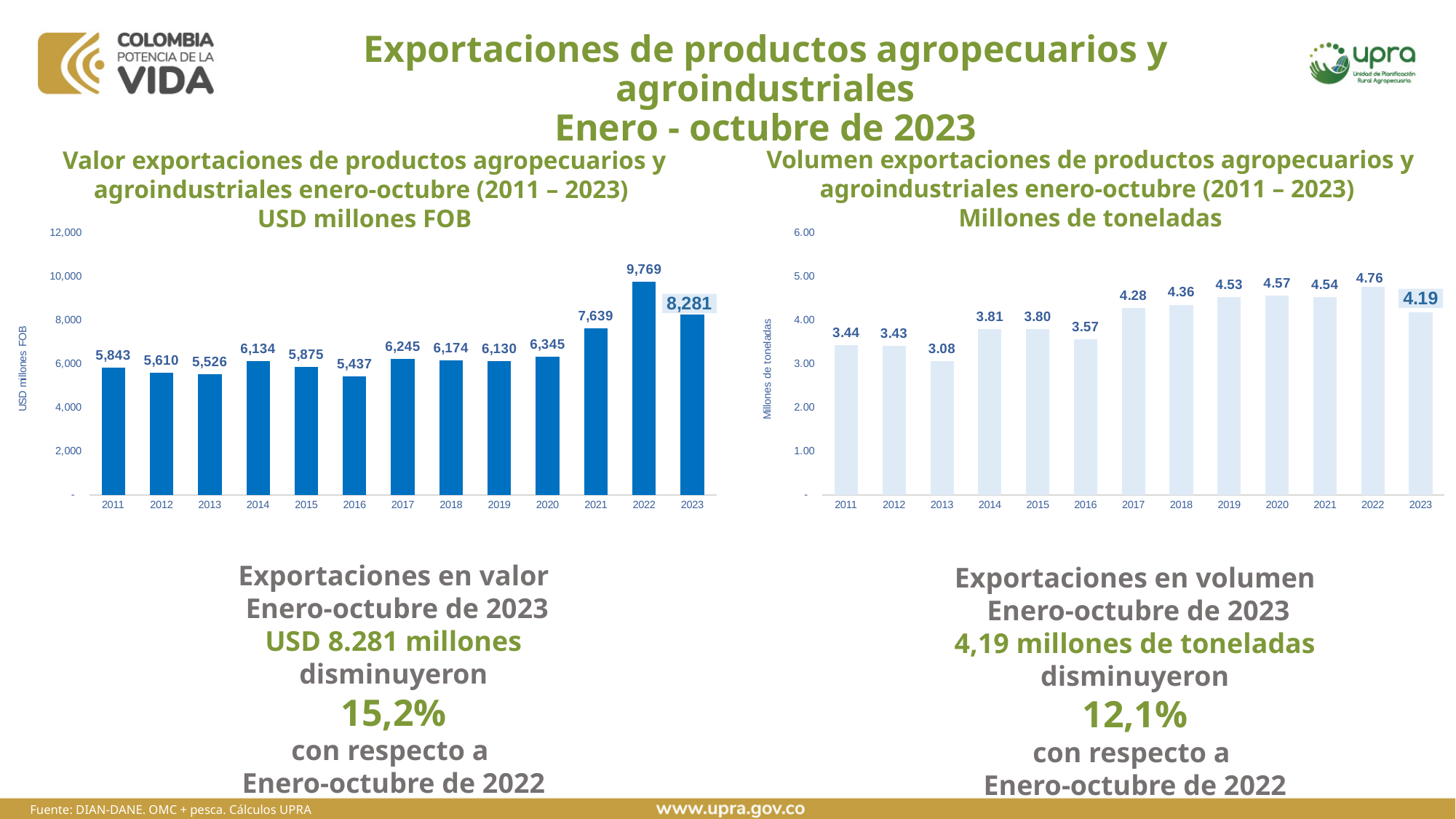
What is the y-axis label of the right chart (Volumen exportaciones)? Millones de toneladas What kind of chart is the left chart (Valor exportaciones, USD millones FOB)? Bar chart In the left chart (Valor exportaciones, USD millones FOB), what is the value for 2023? 8,281 In the right chart (Volumen exportaciones, Millones de toneladas), which year has the lowest value? 2013 In the left chart (Valor exportaciones, USD millones FOB), how many years are plotted? 13 In the right chart (Volumen exportaciones, Millones de toneladas), which is larger: the value for 2017 or the value for 2023? 2017 In the left chart (Valor exportaciones, USD millones FOB), which year has the highest value? 2022 In the left chart (Valor exportaciones, USD millones FOB), what is the difference between the 2022 and 2023 values? 1,488 In the right chart (Volumen exportaciones, Millones de toneladas), what is the difference between the 2022 and 2023 values? 0.57 In the right chart (Volumen exportaciones, Millones de toneladas), what is the value for 2019? 4.53 In the right chart (Volumen exportaciones, Millones de toneladas), which year has the highest value? 2022 In the left chart (Valor exportaciones, USD millones FOB), which year has the lowest value? 2016